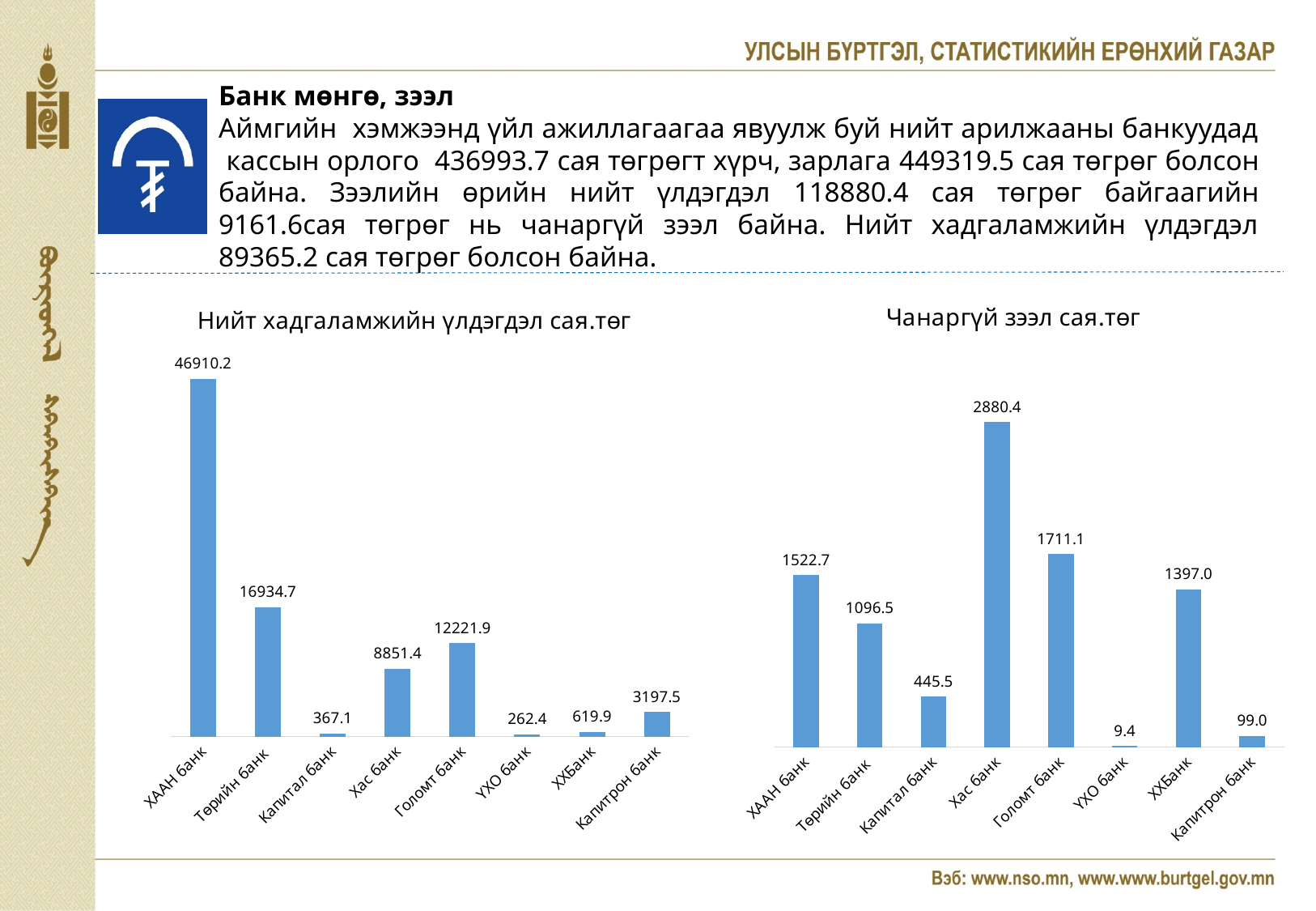
In the chart titled "Нийт хадгаламжийн үлдэгдэл сая.төг", what is the value for Голомт банк? 12221.9 In the chart titled "Нийт хадгаламжийн үлдэгдэл сая.төг", what is the value for ХААН банк? 46910.2 In the chart titled "Чанаргүй зээл сая.төг", what is the value for Хас банк? 2880.4 What is the title of the chart on the left side of the slide? Нийт хадгаламжийн үлдэгдэл сая.төг In the chart titled "Нийт хадгаламжийн үлдэгдэл сая.төг", which bank has the lowest value? ҮХО банк What type of chart is the chart titled "Чанаргүй зээл сая.төг"? Bar chart In the chart titled "Чанаргүй зээл сая.төг", which is larger: ХААН банк or ХХБанк? ХААН банк In the chart titled "Чанаргүй зээл сая.төг", what is the difference between Голомт банк and Төрийн банк? 614.6 In the chart titled "Чанаргүй зээл сая.төг", which bank has the highest value? Хас банк In the chart titled "Чанаргүй зээл сая.төг", what is the value for Капитрон банк? 99.0 In the chart titled "Нийт хадгаламжийн үлдэгдэл сая.төг", what is the difference between Төрийн банк and Хас банк? 8083.3 In the chart titled "Нийт хадгаламжийн үлдэгдэл сая.төг", how many banks are shown? 8